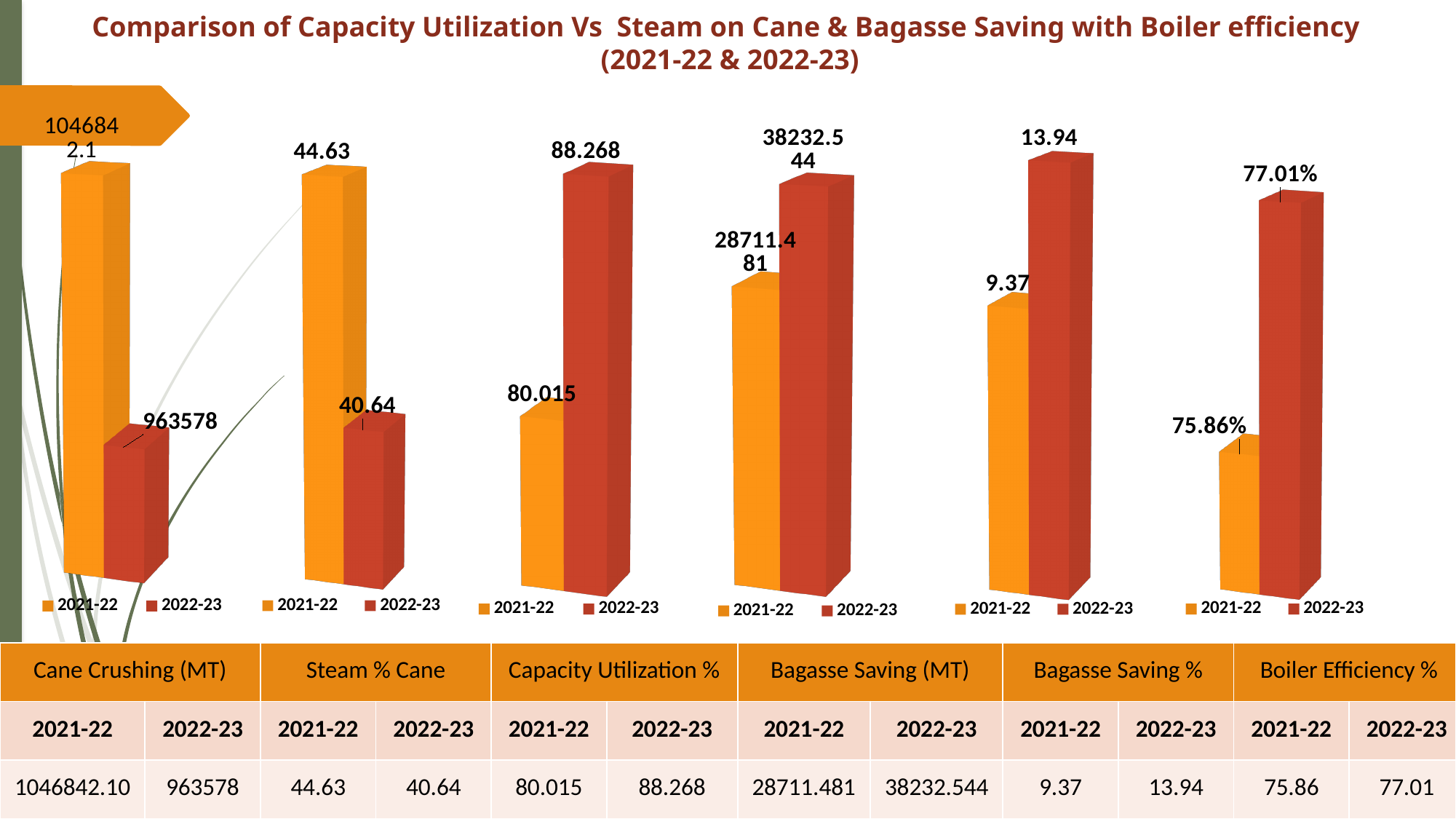
How many series does the legend of the Boiler Efficiency % chart (rightmost) list? 2 In the Steam % Cane chart (second from left), which year has the higher value? 2021-22 In the Bagasse Saving % chart (fifth from left), what is the difference between the 2022-23 and 2021-22 values? 4.57 How many separate bar charts are shown on the slide? 6 In the Bagasse Saving (MT) chart (fourth from left), which year has the lower value? 2021-22 In the Capacity Utilization % chart (third from left), what is the value for 2022-23? 88.268 In the Steam % Cane chart (second from left), what is the difference between the 2021-22 and 2022-23 values? 3.99 What kind of chart is used for the Capacity Utilization % comparison (third from left)? Bar chart In the Bagasse Saving % chart (fifth from left), what is the value for 2022-23? 13.94 In the Boiler Efficiency % chart (rightmost), what is the value for 2021-22? 75.86% In the Cane Crushing (MT) chart (leftmost), what is the value for 2022-23? 963578 In the Steam % Cane chart (second from left), what is the value for 2021-22? 44.63